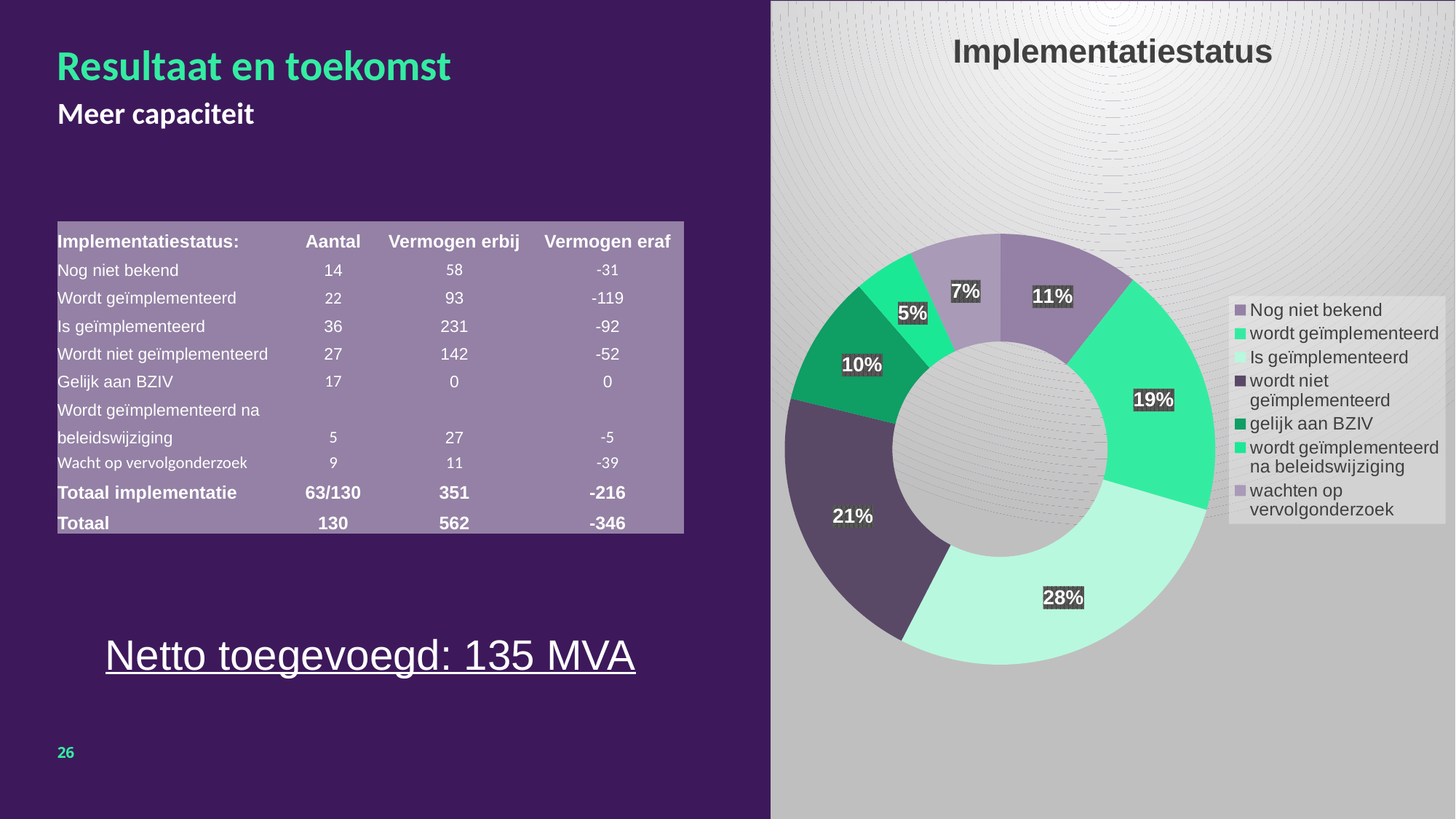
What percentage does the 'Nog niet bekend' slice show? 11% What kind of chart is shown on the slide? Doughnut chart What percentage does the 'wachten op vervolgonderzoek' slice show? 7% What percentage does the 'wordt niet geïmplementeerd' slice show? 21% What is the title of the chart? Implementatiestatus Which category has the largest share of the chart? Is geïmplementeerd Which category has the smallest share of the chart? wordt geïmplementeerd na beleidswijziging Which is larger: the share for 'wordt niet geïmplementeerd' or the share for 'wordt geïmplementeerd'? wordt niet geïmplementeerd What percentage does the 'gelijk aan BZIV' slice show? 10% How many categories does the legend of the chart list? 7 What percentage does the 'Is geïmplementeerd' slice show? 28% What is the difference in percentage points between 'Is geïmplementeerd' and 'wordt geïmplementeerd'? 9